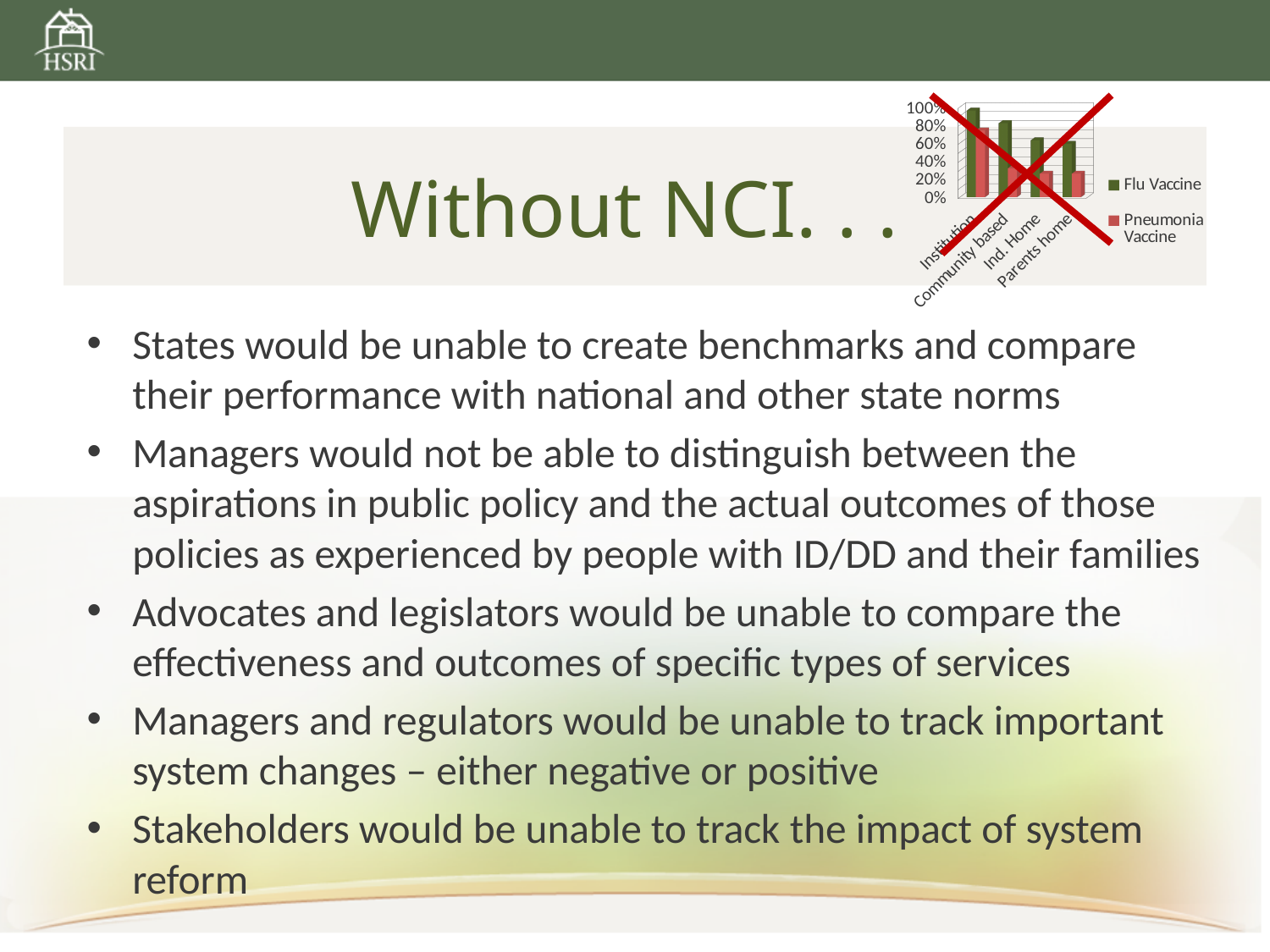
For Institution, which is larger: Flu Vaccine or Pneumonia Vaccine? Flu Vaccine Which category has the highest Flu Vaccine value? Institution Is the Pneumonia Vaccine value for Parents home greater or less than 40%? less What kind of chart is shown in the top right of the slide? bar chart Which category has the highest Pneumonia Vaccine value? Institution Do the Flu Vaccine values rise or fall moving from Institution to Parents home along the x axis? fall How many series does the chart's legend list? 2 How many categories are shown on the chart's x axis? 4 Is the Flu Vaccine value for Institution greater or less than 80%? greater What colour represents the Pneumonia Vaccine series in the chart? red Is the Flu Vaccine value for Community based greater or less than 60%? greater